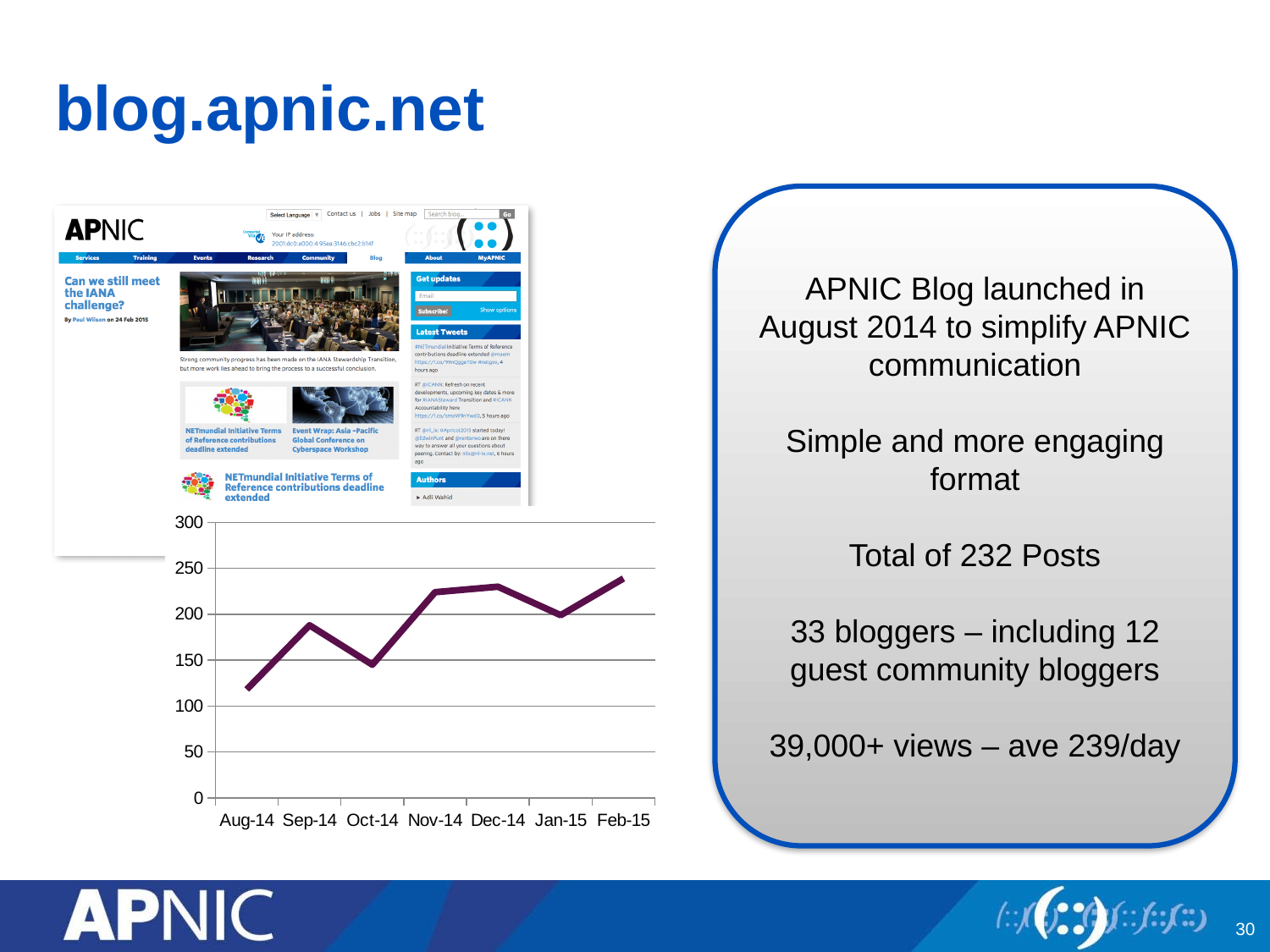
How many months are plotted along the x axis of the chart? 7 Which month has the lowest value on the chart? Aug-14 Does the line rise or fall from Sep-14 to Oct-14? fall Is the value for Sep-14 greater or less than 150? greater What is the highest value shown on the chart's y axis? 300 Which is larger, the value for Aug-14 or the value for Nov-14? Nov-14 Is the value for Feb-15 greater or less than 200? greater Is the value for Oct-14 greater or less than 200? less Which is larger, the value for Sep-14 or the value for Oct-14? Sep-14 What kind of chart is shown on the slide? line chart